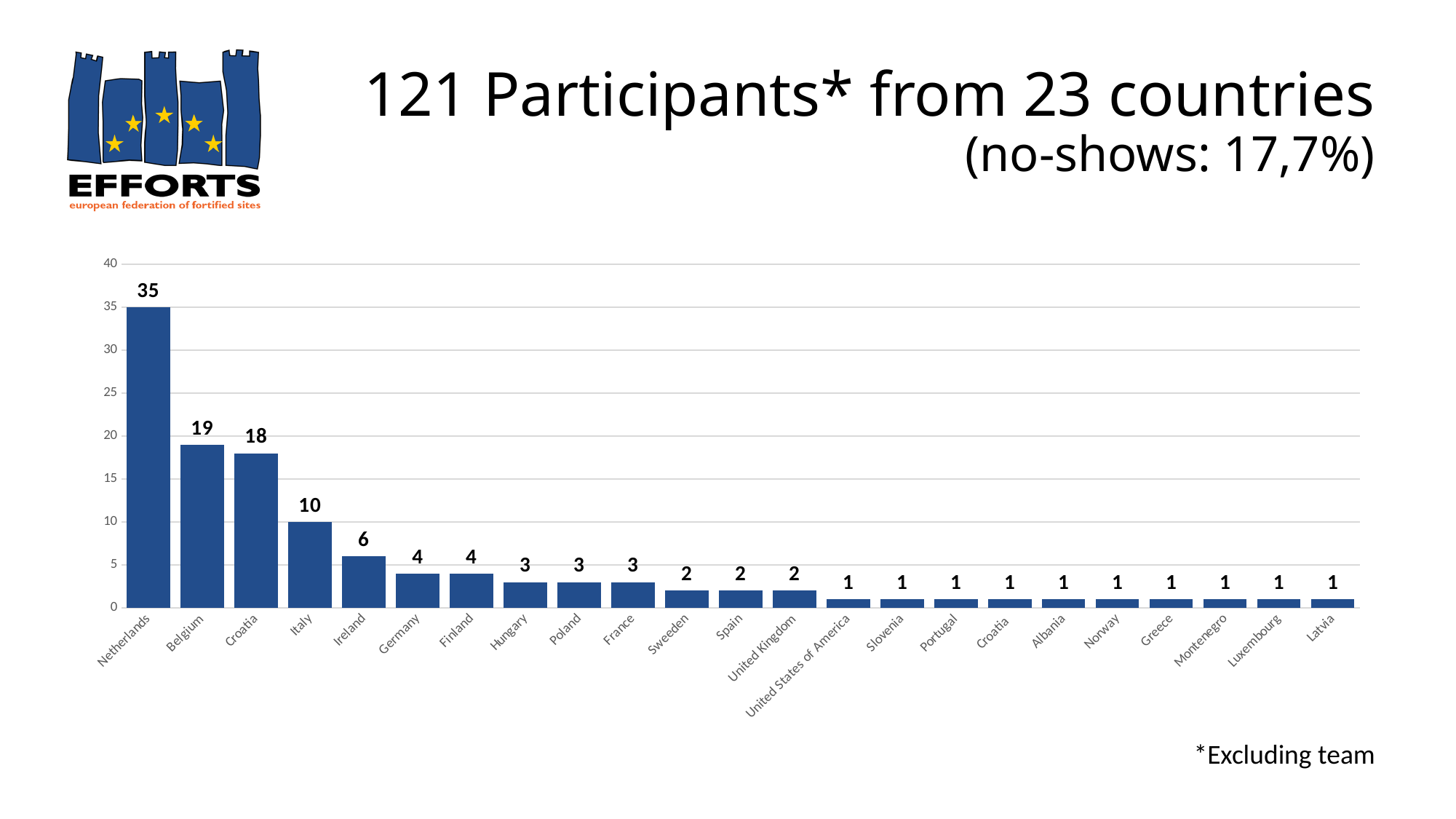
What is the value for Belgium? 19 Which has a larger value, Italy or Ireland? Italy How many participants are shown for the Netherlands? 35 Which country has the highest number of participants? Netherlands How many countries (bars) are shown in the chart? 23 Do the values rise or fall from left to right along the x axis? fall What is the value for Italy? 10 What kind of chart is shown on the slide? bar chart Is the value for the Netherlands greater or less than 30? greater What is the value for Ireland? 6 What is the difference between the values for the Netherlands and Belgium? 16 What is the value for Sweden? 2